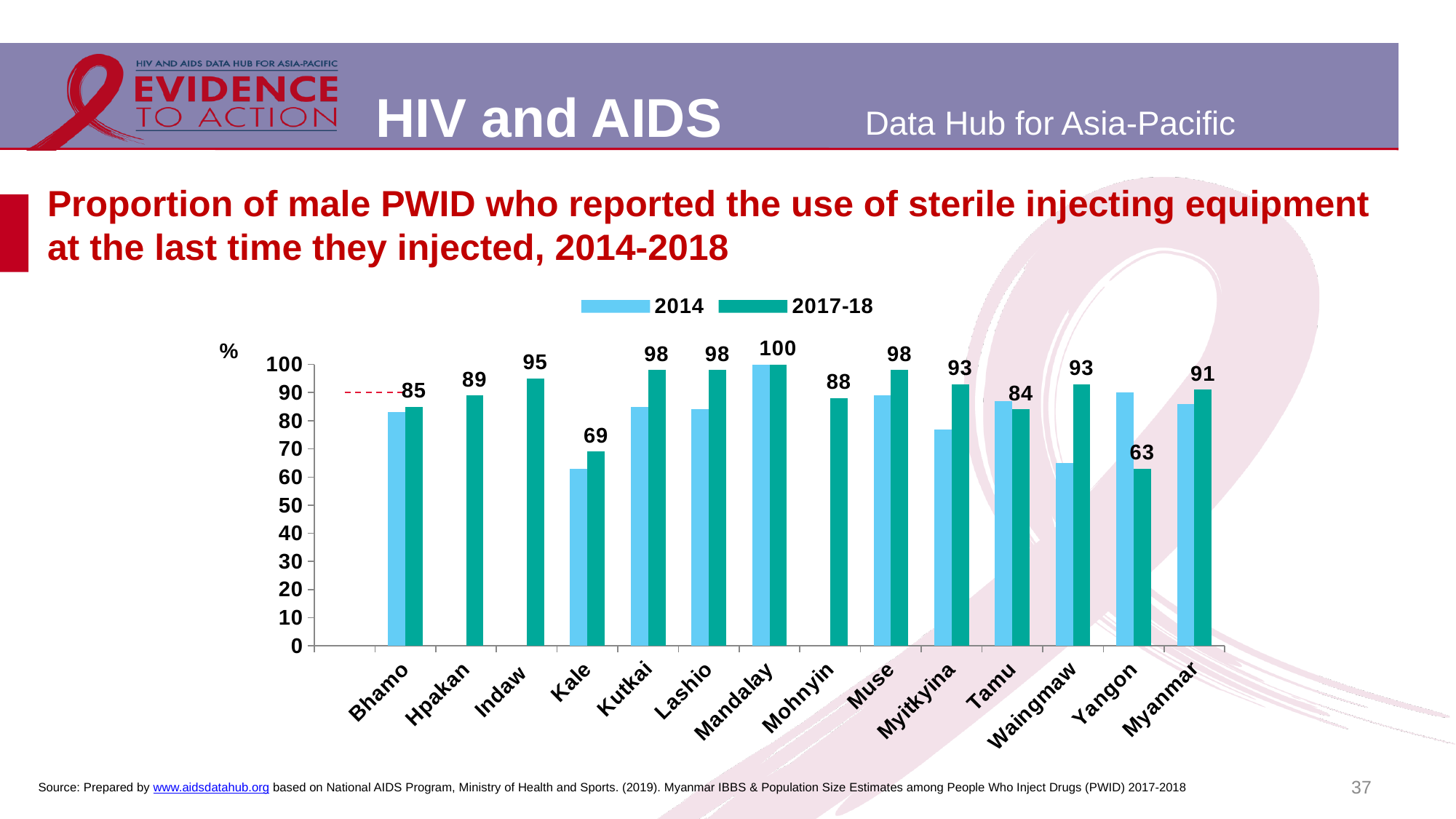
Is the 2014 value for Waingmaw greater or less than 70? less How many categories are shown on the x axis? 14 Which category has the highest 2017-18 value? Mandalay Which has a higher 2017-18 value, Indaw or Tamu? Indaw What is the difference between the 2017-18 values for Mandalay and Yangon? 37 Which category has the lowest 2017-18 value? Yangon How many series does the legend list? 2 Is the 2014 value for Yangon greater or less than 80? greater What is the 2017-18 value for Kale? 69 What kind of chart is shown on the slide? Bar chart What is the 2017-18 value for Mohnyin? 88 What is the 2017-18 value for Myanmar? 91